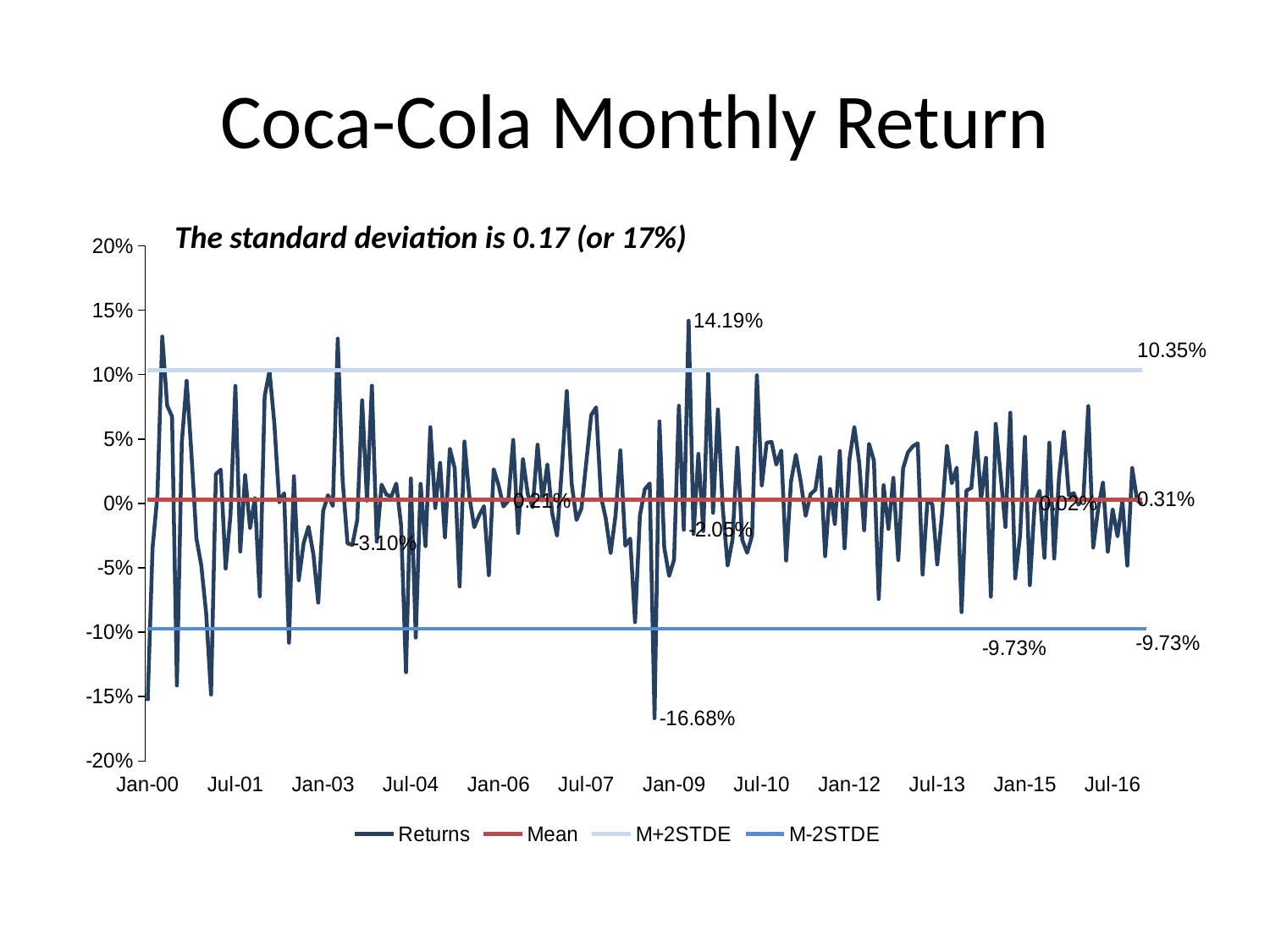
What is the highest labelled monthly return on the chart? 14.19% What is the difference between the M+2STDE line (10.35%) and the M-2STDE line (-9.73%)? 20.08% What is the value of the M+2STDE line? 10.35% What kind of chart is shown on the slide? line chart What are the four series listed in the legend? Returns, Mean, M+2STDE, M-2STDE What is the value of the Mean line? 0.31% According to the text on the chart, what is the standard deviation? 0.17 (or 17%) How many series does the legend list? 4 What is the difference between the highest labelled return (14.19%) and the lowest labelled return (-16.68%)? 30.87% Is the highest labelled monthly return greater or less than 10%? greater What is the value of the M-2STDE line? -9.73% What is the lowest labelled monthly return on the chart? -16.68%